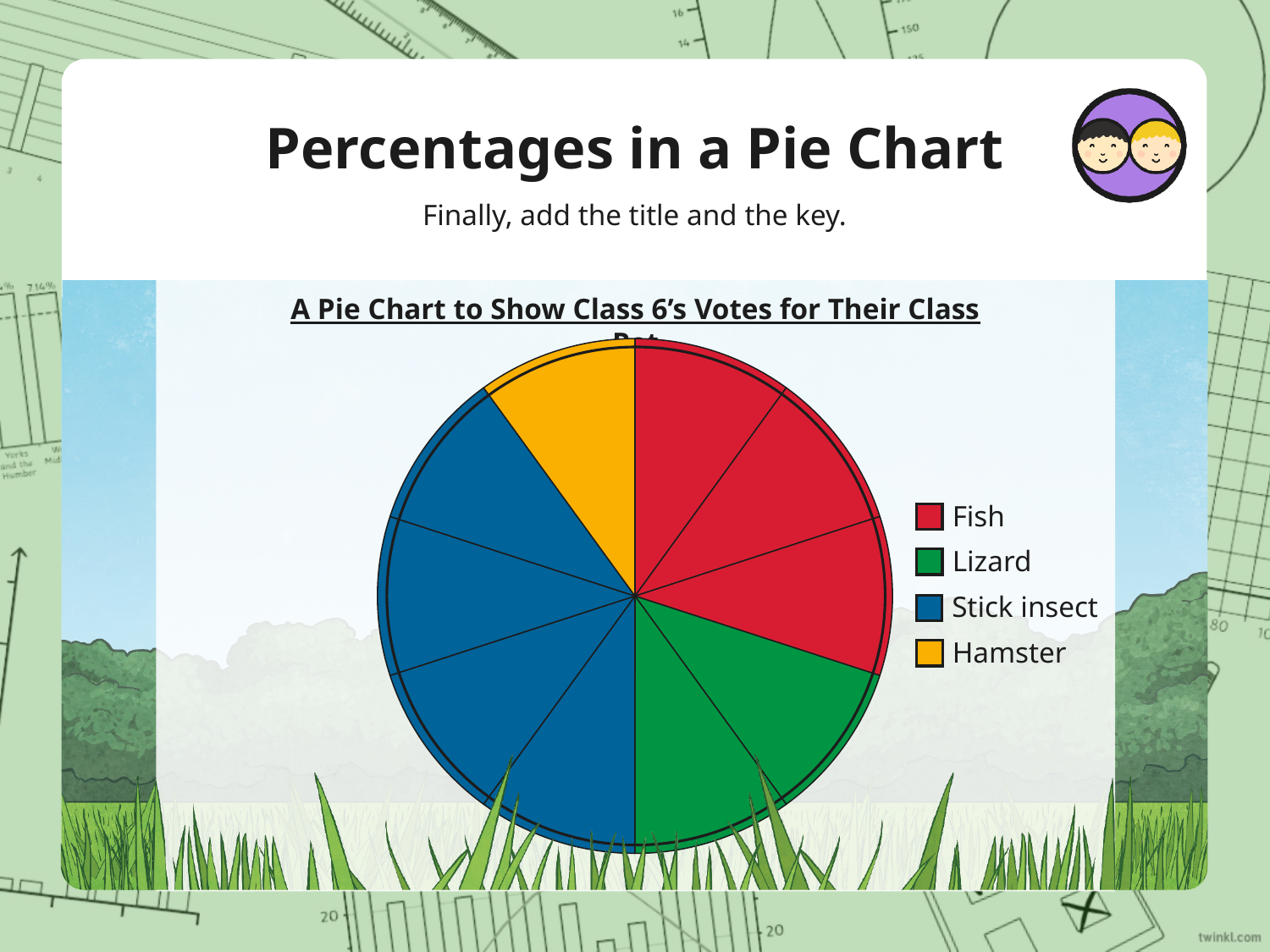
What kind of chart is shown on the slide? Pie chart Which slice is larger, Stick insect or Hamster? Stick insect Which category is shown in yellow in the pie chart? Hamster Which category has the largest slice of the pie chart? Stick insect Which slice is larger, Fish or Lizard? Fish What colour represents Stick insect in the pie chart? Blue Which category has the smallest slice of the pie chart? Hamster Which slice is larger, Stick insect or Fish? Stick insect How many categories does the pie chart's key list? 4